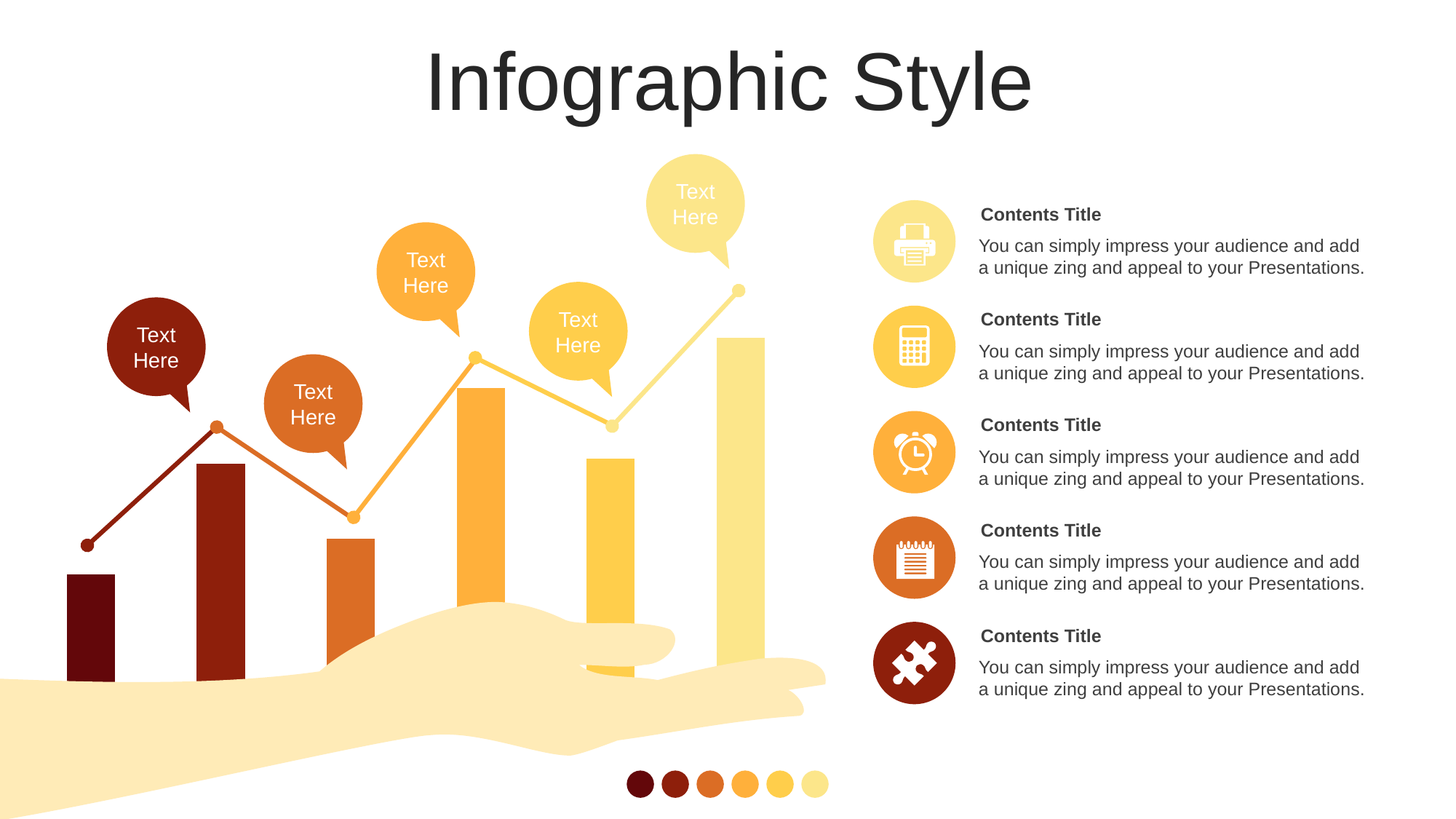
How many 'Text Here' speech-bubble callouts are placed above the chart? 5 Is the fourth bar from the left taller or shorter than the fifth bar? taller What kind of chart is shown on the left of the slide? bar chart with a line overlay Is the sixth bar taller or shorter than the fourth bar? taller How many points are marked on the line overlaid on the bars? 6 Is the second bar from the left taller or shorter than the third bar? taller Which bar is the shortest in the chart? the first (leftmost) bar What colour is the leftmost bar in the chart? dark red Which bar is the tallest in the chart? the sixth (rightmost) bar Do the bar heights generally rise or fall from left to right across the chart? rise How many bars are plotted in the chart? 6